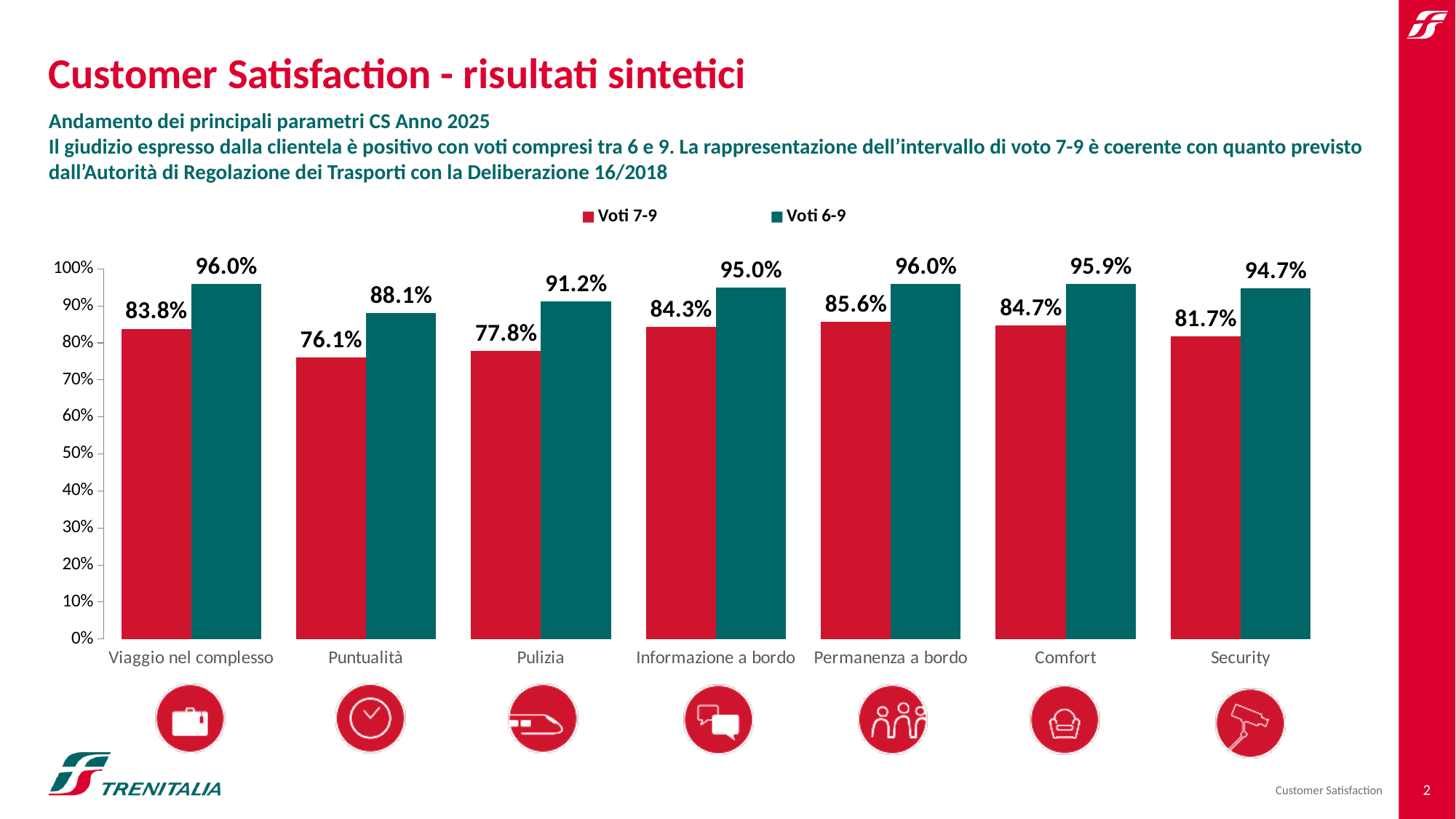
Which category has the highest Voti 7-9 value? Permanenza a bordo What is the difference between the Voti 6-9 and Voti 7-9 values for Puntualità? 12.0 percentage points How many series does the chart legend list? 2 What kind of chart is shown on the slide? Bar chart Which is larger: the Voti 7-9 value for Viaggio nel complesso or the Voti 7-9 value for Security? Viaggio nel complesso What is the Voti 6-9 value for Security? 94.7% How many categories are shown on the x axis of the chart? 7 What is the Voti 7-9 value for Puntualità? 76.1% What is the Voti 7-9 value for Comfort? 84.7% Which category has the lowest Voti 6-9 value? Puntualità Is the Voti 7-9 value for Pulizia greater or less than 80%? less What is the Voti 6-9 value for Pulizia? 91.2%